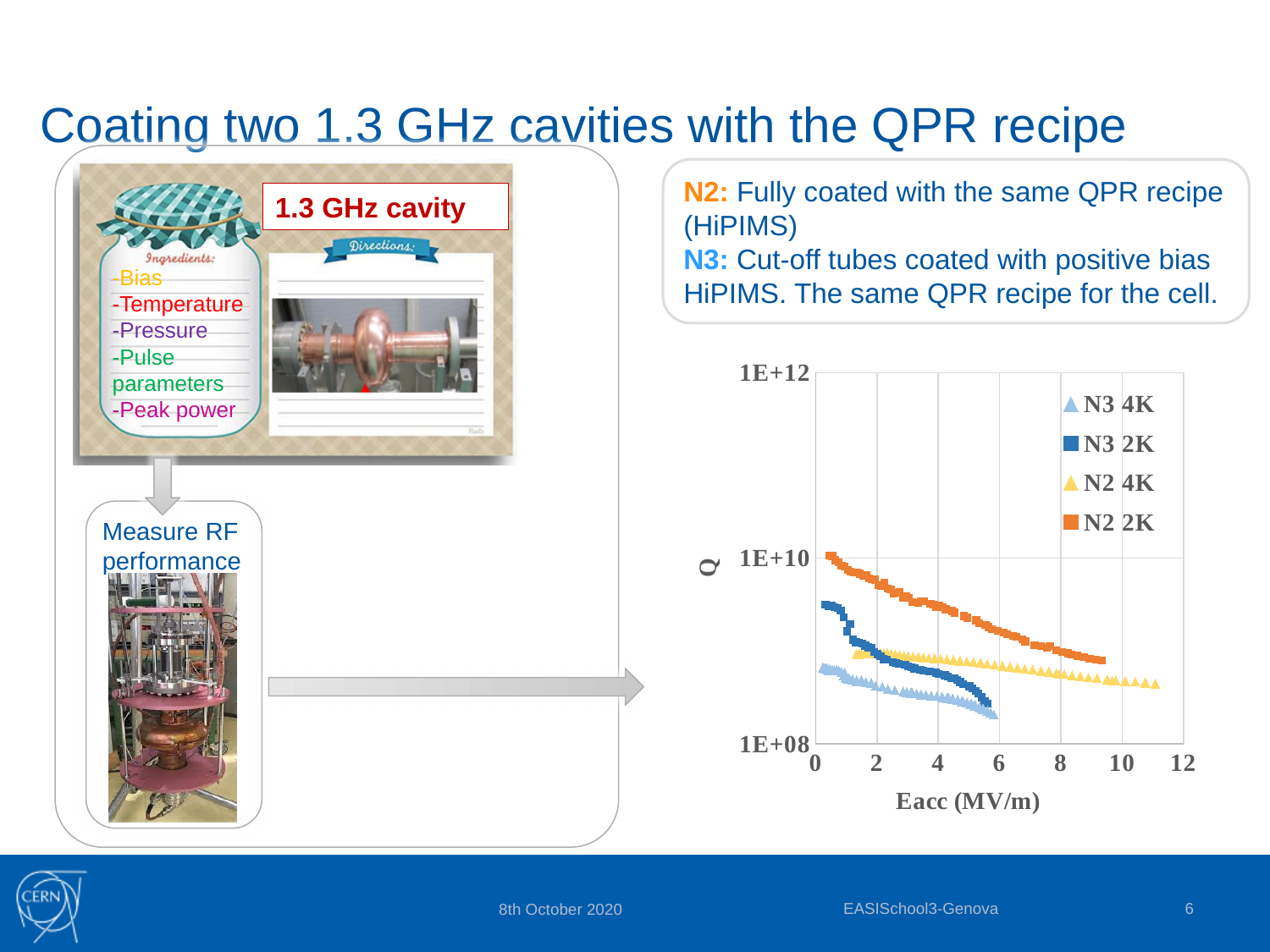
Is the Q value for N3 4K at Eacc = 2 MV/m greater or less than 1E+10? less Which series has the highest Q values across the chart? N2 2K At Eacc = 4 MV/m, which series has the larger Q: N2 4K or N3 4K? N2 4K At Eacc = 4 MV/m, which series has the larger Q: N2 2K or N3 2K? N2 2K What kind of chart is shown on the slide? Scatter plot How does Q for the N2 2K series change as Eacc increases? It decreases What is the label of the y axis of the chart? Q Which series has the lowest Q values across the chart? N3 4K How many series does the chart legend list? 4 What is the label of the x axis of the chart? Eacc (MV/m) Is the Q value for N2 2K at Eacc = 8 MV/m greater or less than 1E+08? greater Which series extends to the highest Eacc value on the chart? N2 4K